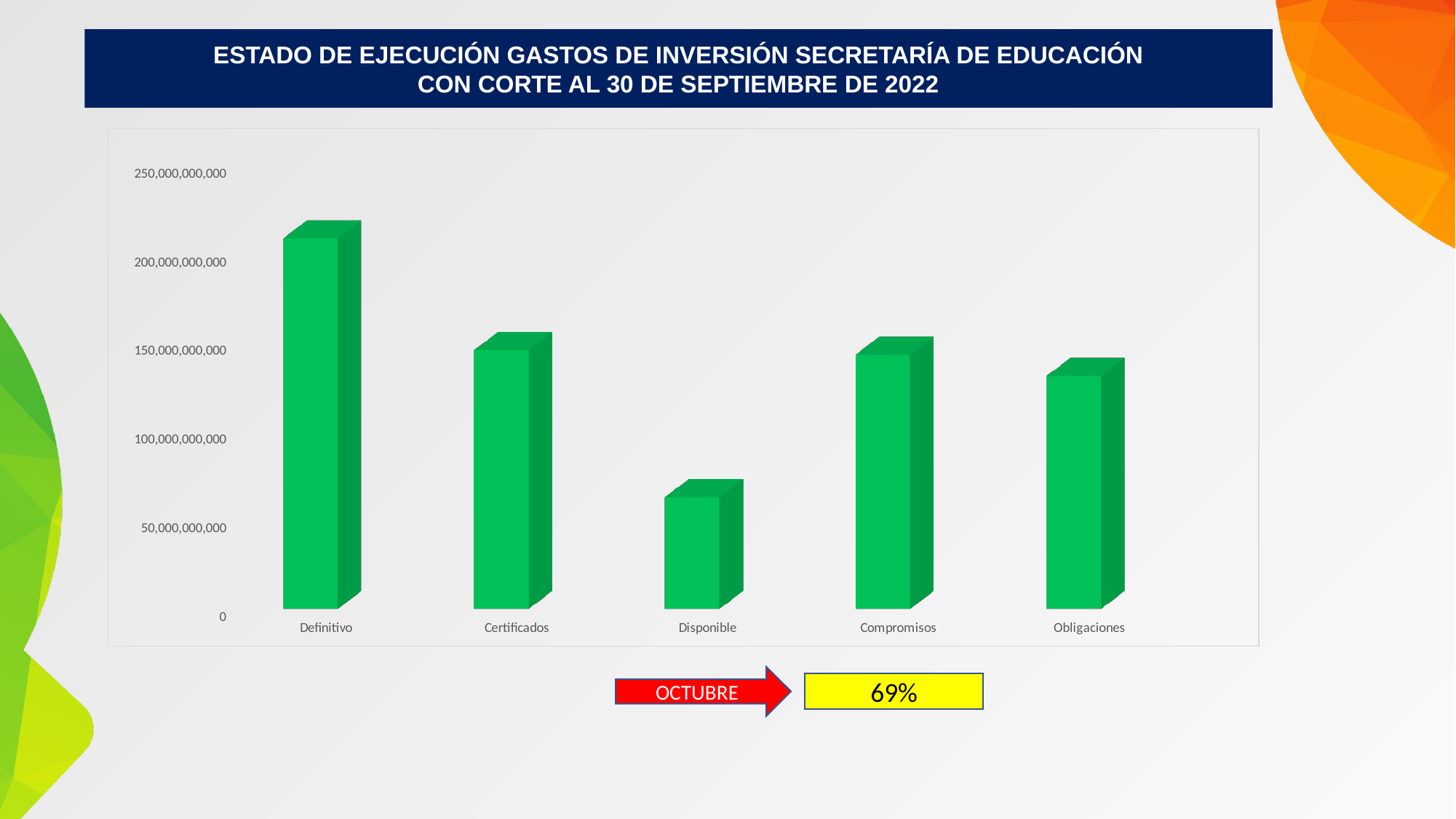
Is the value for Disponible greater or less than 50,000,000,000? greater How many categories are plotted on the chart? 5 Is the value for Definitivo greater or less than 200,000,000,000? greater What kind of chart is shown on the slide? bar chart Is the value for Compromisos greater or less than 100,000,000,000? greater Which is larger, the value for Disponible or the value for Obligaciones? Obligaciones Which category has the highest value? Definitivo Which category has the lowest value? Disponible Which is larger, the value for Definitivo or the value for Certificados? Definitivo What percentage is shown in the yellow box below the chart? 69%